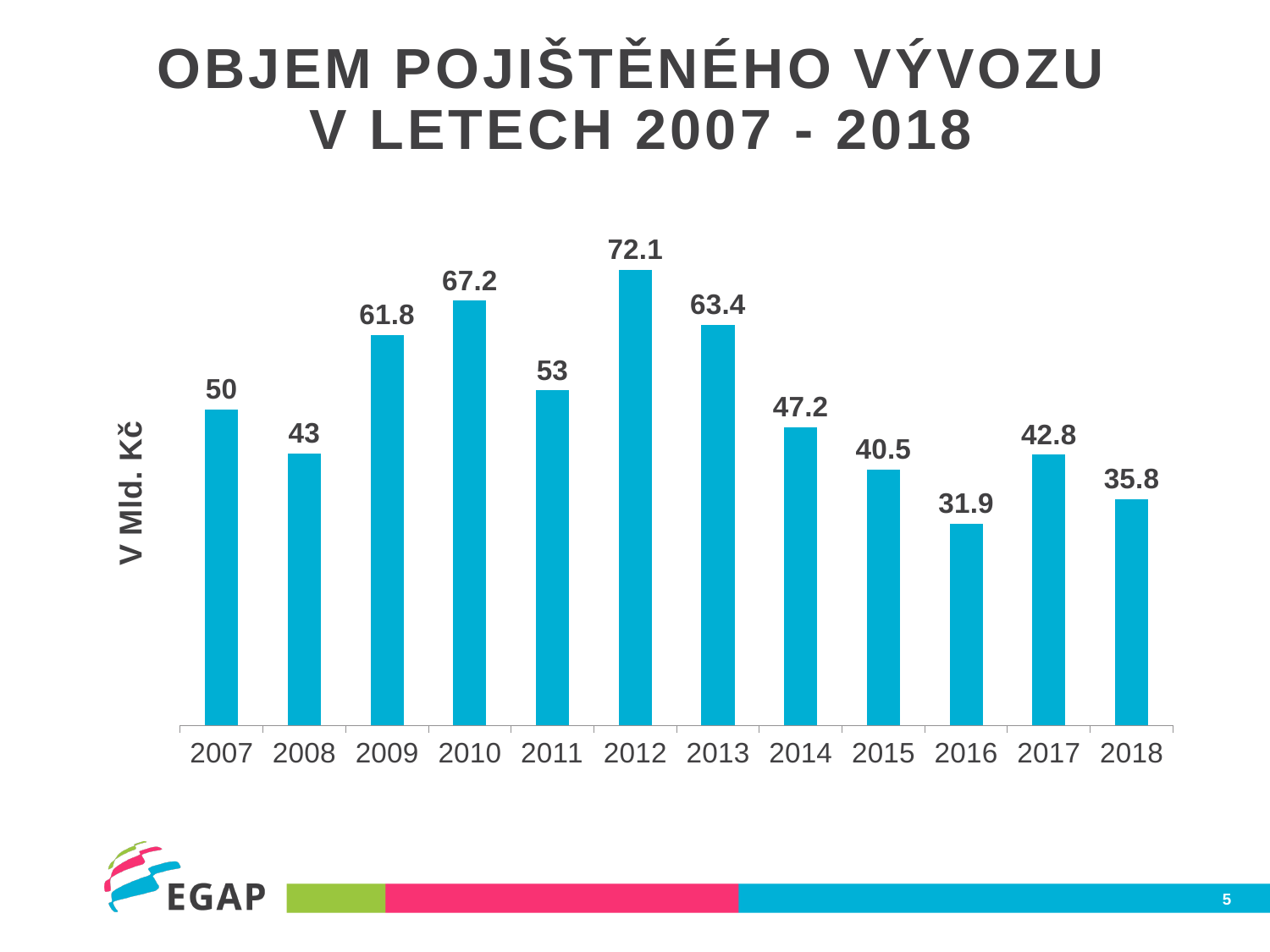
What kind of chart is this? bar chart Which year has the highest value? 2012 What is the value for 2012? 72.1 What is the value for 2016? 31.9 What is the difference between the values for 2012 and 2013? 8.7 What is the y-axis label? V Mld. Kč Which is larger, the value for 2014 or the value for 2017? 2014 Do the values rise or fall from 2013 to 2016? fall Which year has the lowest value? 2016 What is the value for 2009? 61.8 What is the difference between the values for 2007 and 2008? 7 How many years are shown on the x axis? 12